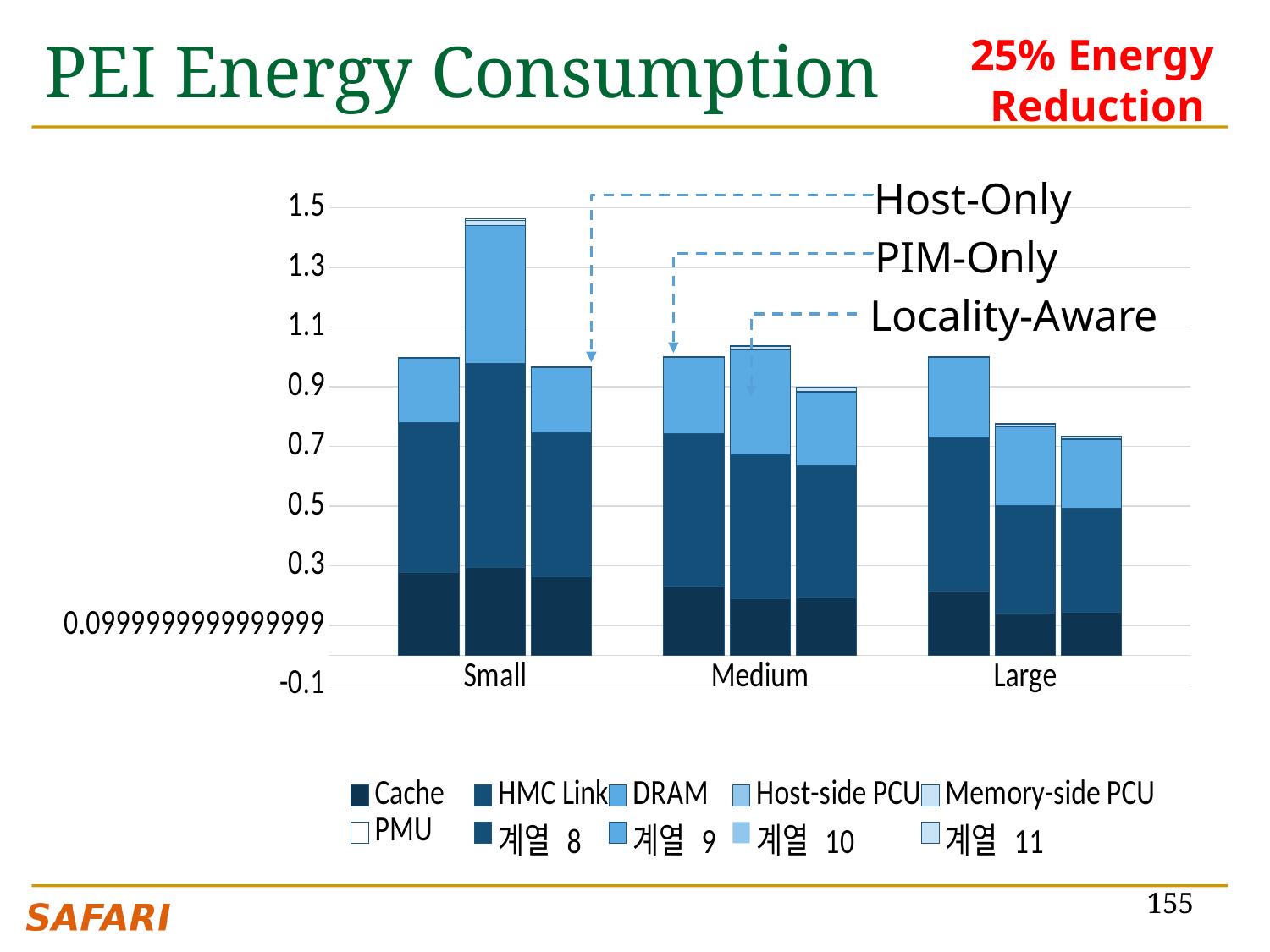
Is the total value of the PIM-Only bar for Medium greater or less than 0.9? greater For Small, which bar is taller: Host-Only or PIM-Only? PIM-Only Is the total value of the PIM-Only bar for Small greater or less than 1.3? greater Which bar configuration is labelled by the dashed arrow pointing to the middle bar of each group? PIM-Only What kind of chart is shown on the slide? stacked bar chart What is the title of the chart on the slide? PEI Energy Consumption Do the Locality-Aware bars rise or fall from Small to Large? fall Which bar is the tallest in the whole chart? PIM-Only for Small How many categories are shown on the x axis of the chart? 3 For Large, which bar is taller: Host-Only or Locality-Aware? Host-Only How many series does the chart's legend list? 10 Is the total value of the Locality-Aware bar for Large greater or less than 0.9? less